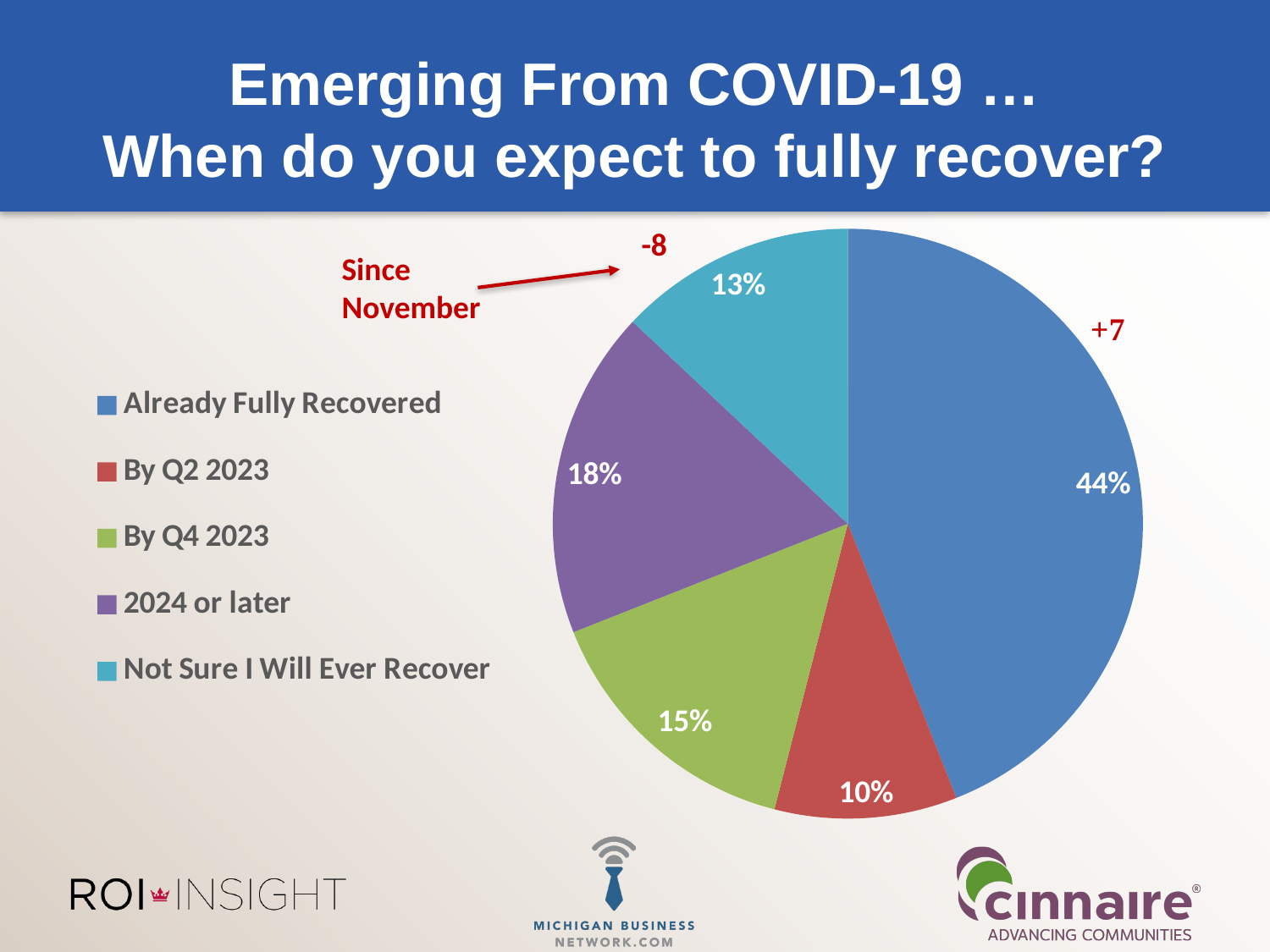
What type of chart is shown on the slide? Pie chart What percentage of respondents are Not Sure I Will Ever Recover? 13% What percentage of respondents expect to recover By Q4 2023? 15% What change since November is annotated next to the Already Fully Recovered slice? +7 What percentage of respondents expect to recover in 2024 or later? 18% What share of the pie is labelled By Q2 2023? 10% How many percentage points larger is the Already Fully Recovered slice than the 2024 or later slice? 26 How many categories does the pie chart show? 5 Which response category has the largest share of the pie? Already Fully Recovered Which response category has the smallest share of the pie? By Q2 2023 What percentage of respondents said they have Already Fully Recovered? 44% Which is larger: the share for By Q4 2023 or the share for Not Sure I Will Ever Recover? By Q4 2023